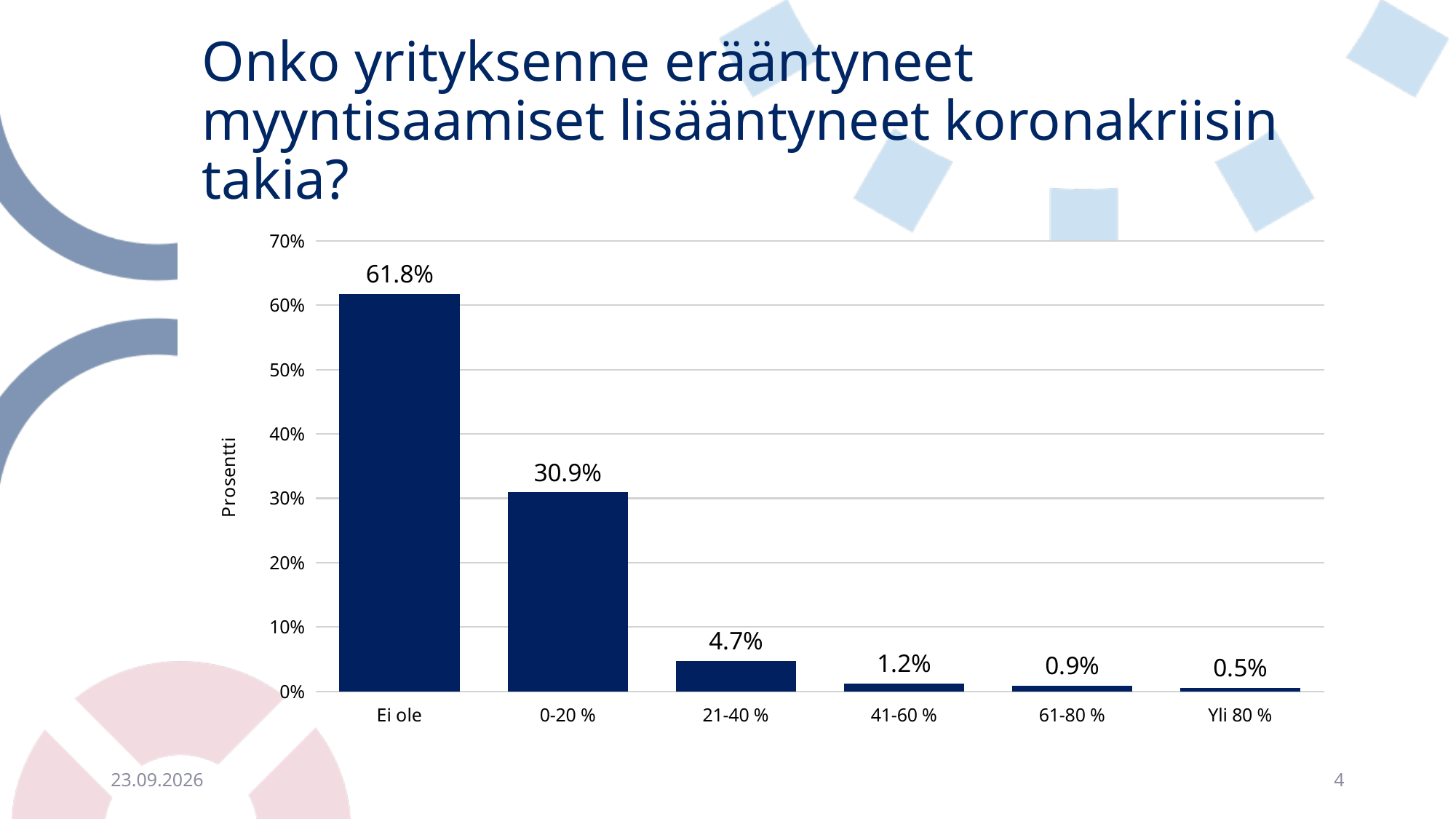
How many categories are shown on the x axis? 6 What is the value for the '0-20 %' category? 30.9% What is the value for the 'Yli 80 %' category? 0.5% What is the value for the 'Ei ole' category? 61.8% Is the value for '0-20 %' greater or less than 40%? less What is the difference between the values for 'Ei ole' and '0-20 %'? 30.9% Which category has the highest value? Ei ole Which category has the lowest value? Yli 80 % What is the value for the '21-40 %' category? 4.7% Which is larger, the value for '41-60 %' or the value for '61-80 %'? 41-60 % What is the label of the vertical axis? Prosentti What kind of chart is shown on the slide? bar chart